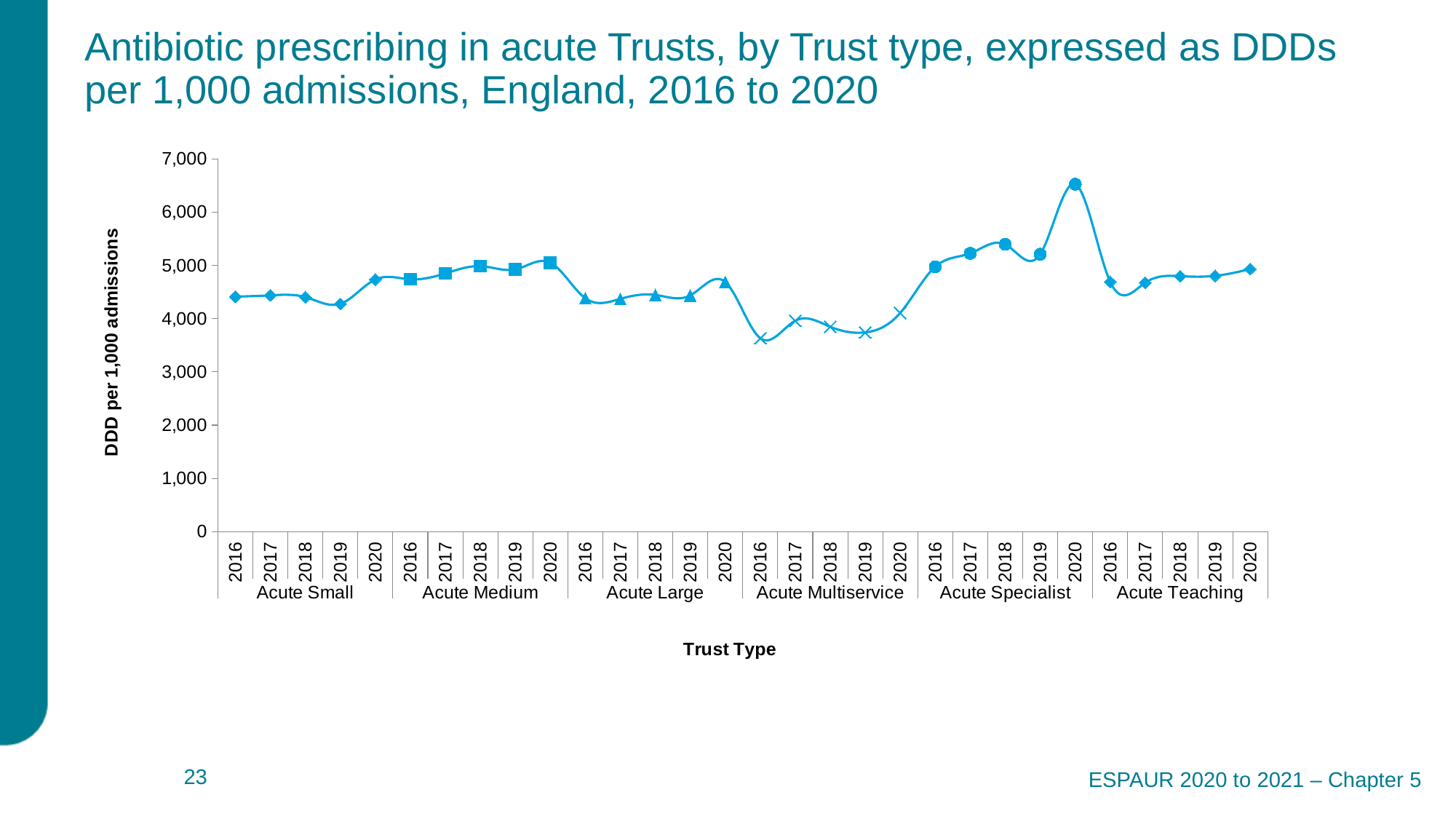
Is the value for Acute Teaching in 2016 greater or less than 5,000? less Which Trust type contains the lowest plotted point on the chart? Acute Multiservice What is the label of the x axis? Trust Type Is the value for Acute Multiservice in 2016 greater or less than 4,000? less Which Trust type and year has the highest DDD per 1,000 admissions? Acute Specialist, 2020 Which is larger: the value for Acute Specialist in 2020 or the value for Acute Small in 2019? Acute Specialist in 2020 Which is larger: the value for Acute Large in 2016 or the value for Acute Multiservice in 2016? Acute Large in 2016 How many Trust types are shown along the x axis? 6 Is the value for Acute Specialist in 2020 greater or less than 6,000? greater How many data points are plotted on the chart in total? 30 What is the label of the y axis? DDD per 1,000 admissions What kind of chart is shown on the slide? Line chart